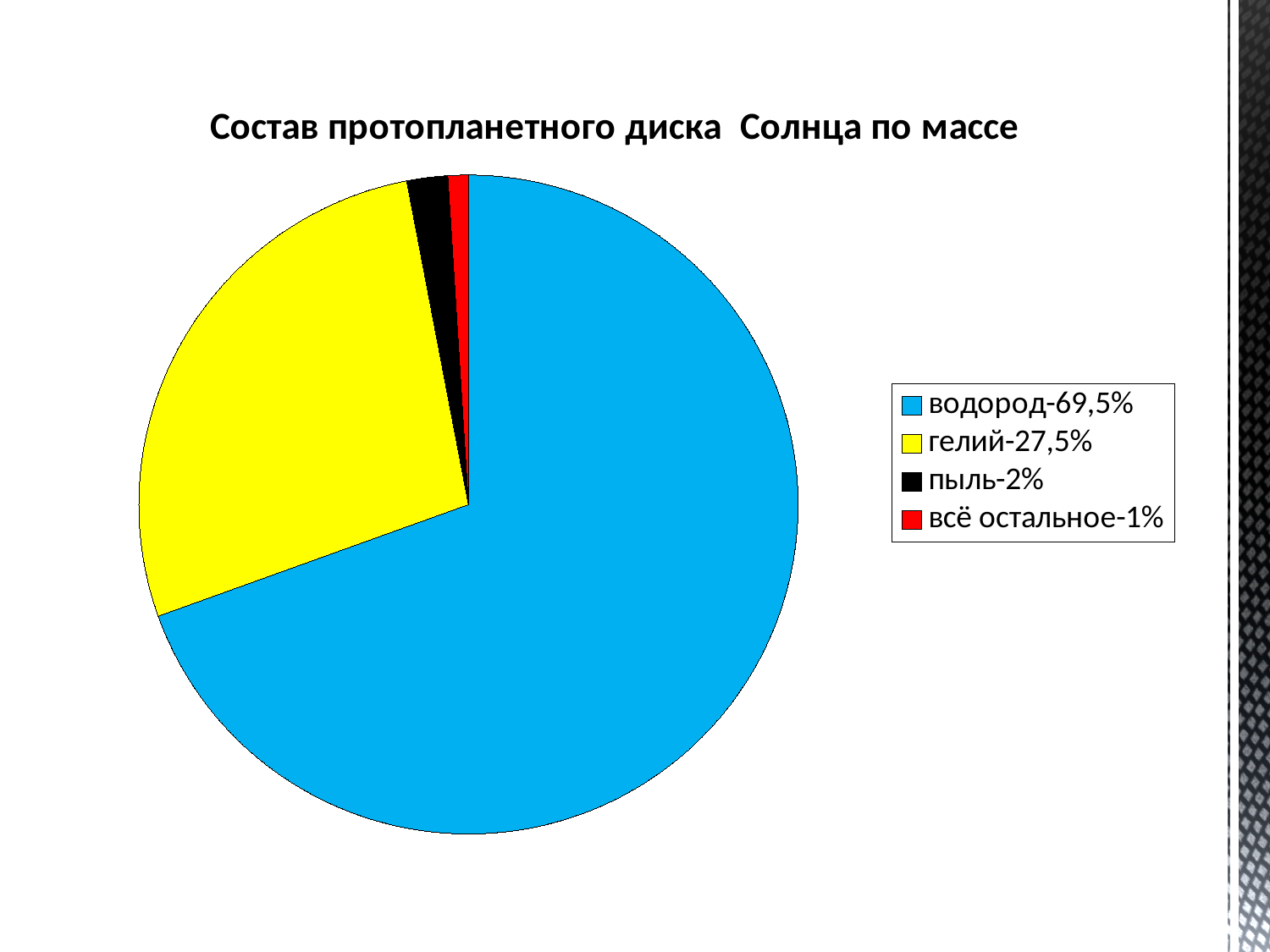
Which is larger, the share of пыль or the share of всё остальное? пыль What is the difference between the shares of водород and гелий? 42% What share of the mass does гелий account for? 27,5% What is the title of the chart? Состав протопланетного диска Солнца по массе What share of the mass does водород account for? 69,5% Which component has the smallest share of the pie? всё остальное What share of the mass does пыль account for? 2% What kind of chart is shown on the slide? pie chart Which component has the largest share of the pie? водород What share of the mass does всё остальное account for? 1% What colour is the slice for гелий? yellow How many slices does the pie chart have? 4